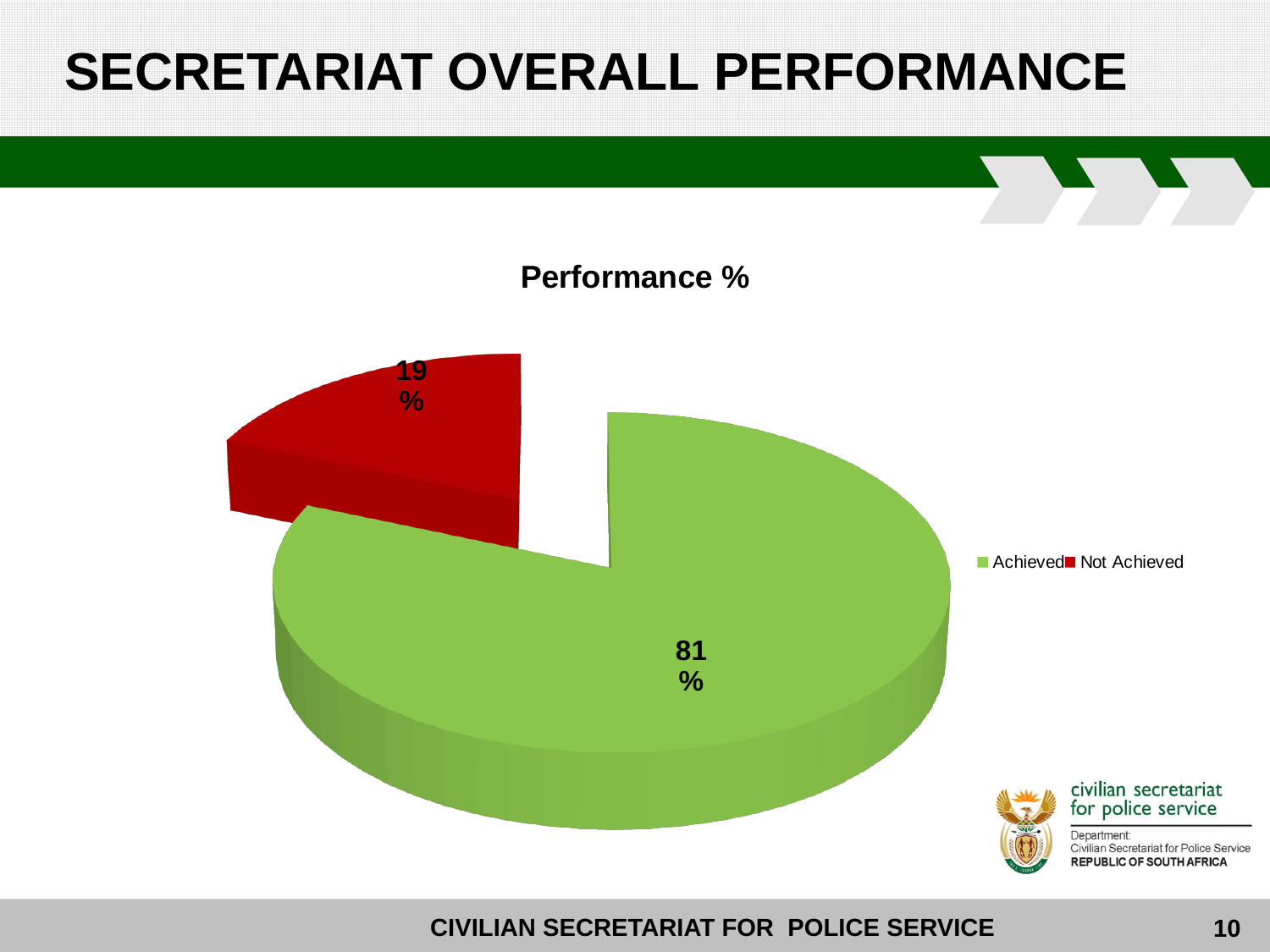
Which slice is the largest? Achieved How many entries does the legend list? 2 What is the difference in percentage points between the Achieved and Not Achieved slices? 62 How many slices does the pie chart have? 2 What share of the pie does the Achieved slice represent? 81% What percentage of the pie is labelled Achieved? 81% What colour is the Not Achieved slice? red Which slice is the smallest? Not Achieved What kind of chart is shown on the slide? pie chart What percentage of the pie is labelled Not Achieved? 19% What is the chart's title? Performance % Which is larger, the Achieved slice or the Not Achieved slice? Achieved